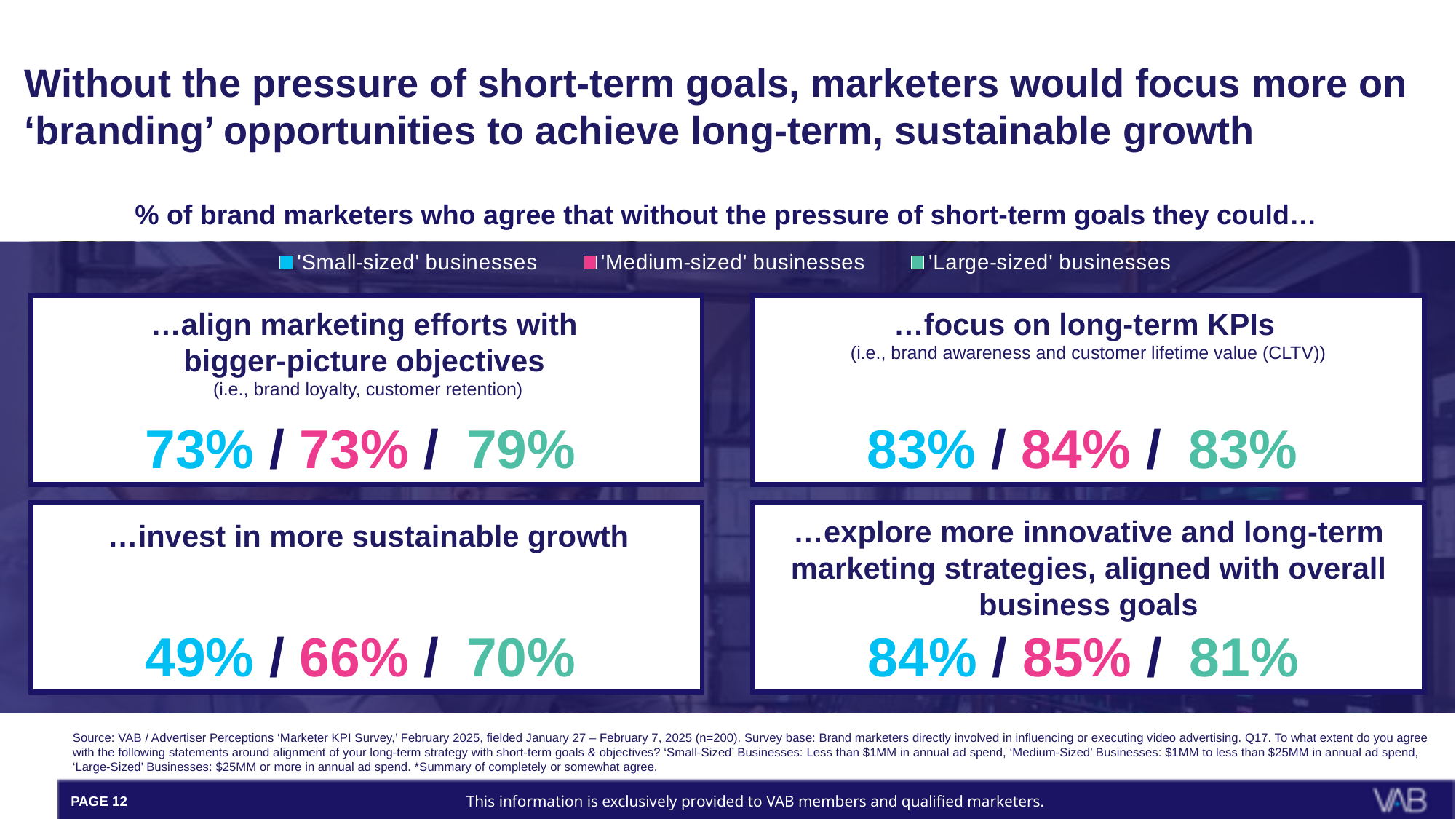
What is the difference between the 'Large-sized' and 'Small-sized' percentages for investing in more sustainable growth? 21 percentage points How many business-size series does the legend list? 3 What percentage of 'Large-sized' business marketers agree they could align marketing efforts with bigger-picture objectives? 79% Which colour represents 'Medium-sized' businesses in the legend? Pink For aligning marketing efforts with bigger-picture objectives, which business size has the highest percentage? 'Large-sized' businesses What percentage of 'Medium-sized' business marketers agree they could focus on long-term KPIs? 84% What is the difference between the 'Medium-sized' and 'Small-sized' percentages for investing in more sustainable growth? 17 percentage points For exploring more innovative and long-term marketing strategies, is the 'Medium-sized' or 'Large-sized' percentage larger? 'Medium-sized' businesses How many statements are shown with percentages on the slide? 4 What percentage of 'Medium-sized' business marketers agree they could explore more innovative and long-term marketing strategies aligned with overall business goals? 85% For investing in more sustainable growth, which business size has the lowest percentage? 'Small-sized' businesses What percentage of 'Small-sized' business marketers agree they could invest in more sustainable growth? 49%